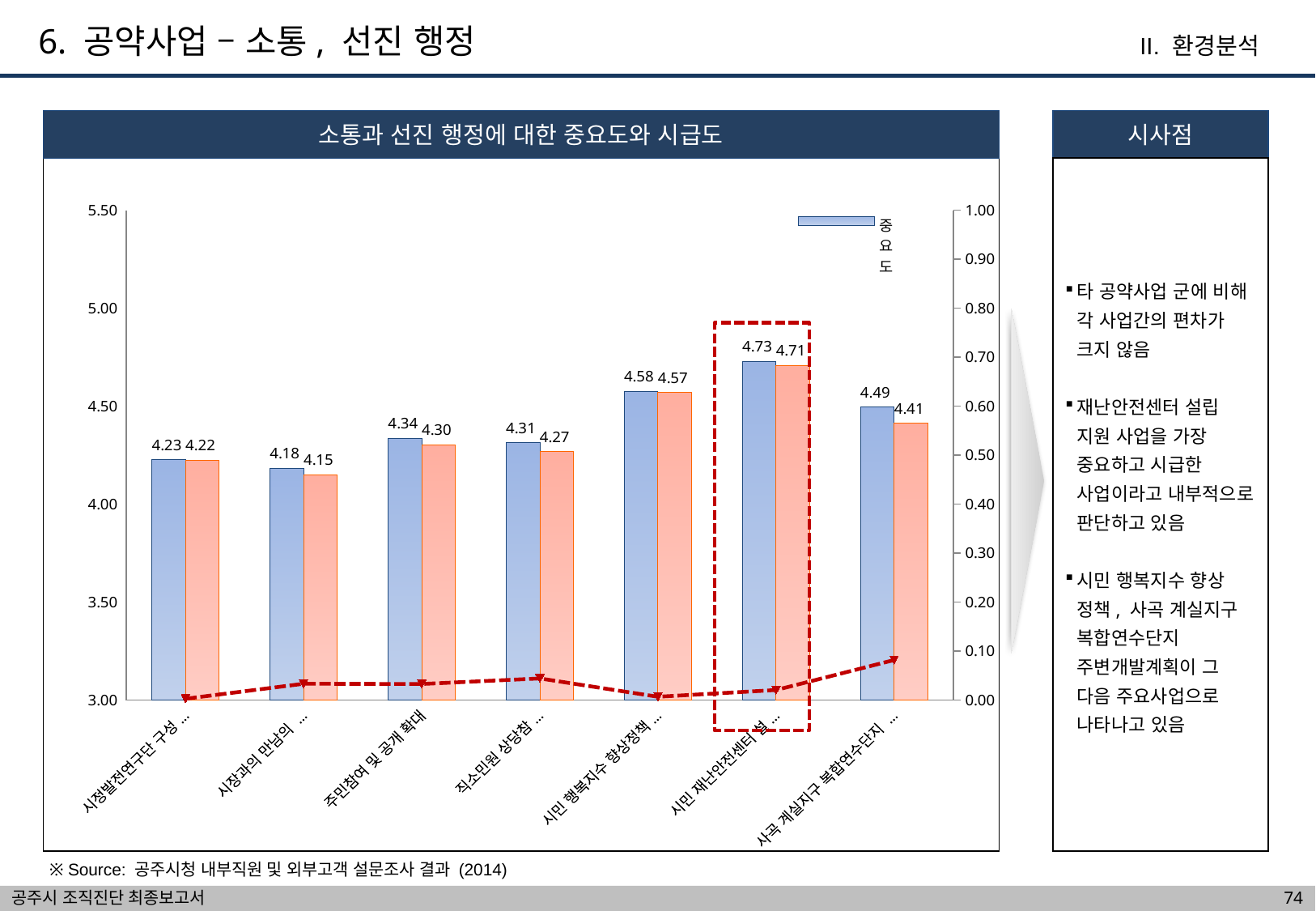
What is the title of the chart? 소통과 선진 행정에 대한 중요도와 시급도 What is the value of the blue bar for 주민참여 및 공개 확대? 4.34 Which is larger: the blue bar for 주민참여 및 공개 확대 or the blue bar for 직소민원 상담참 (fourth category)? 주민참여 및 공개 확대 How many categories are shown on the x axis? 7 What is the value of the blue bar for the sixth category from the left (시민 재난안전센터 ...)? 4.73 What type of chart is shown on the slide? combination bar and line chart Which category has the lowest orange bar? 시장과의 만남의 (second category from the left) What is the difference between the blue and orange bars for the sixth category (시민 재난안전센터 ...)? 0.02 What is the difference between the blue bar for 시민 행복지수 향상정책 (fifth category) and the blue bar for 주민참여 및 공개 확대? 0.24 What is the value of the orange bar for 주민참여 및 공개 확대? 4.30 Is the orange bar for the last category (사곡 계실지구 복합연수단지 ...) greater or less than 4.50? less Which category has the highest blue bar? 시민 재난안전센터 (sixth category from the left)